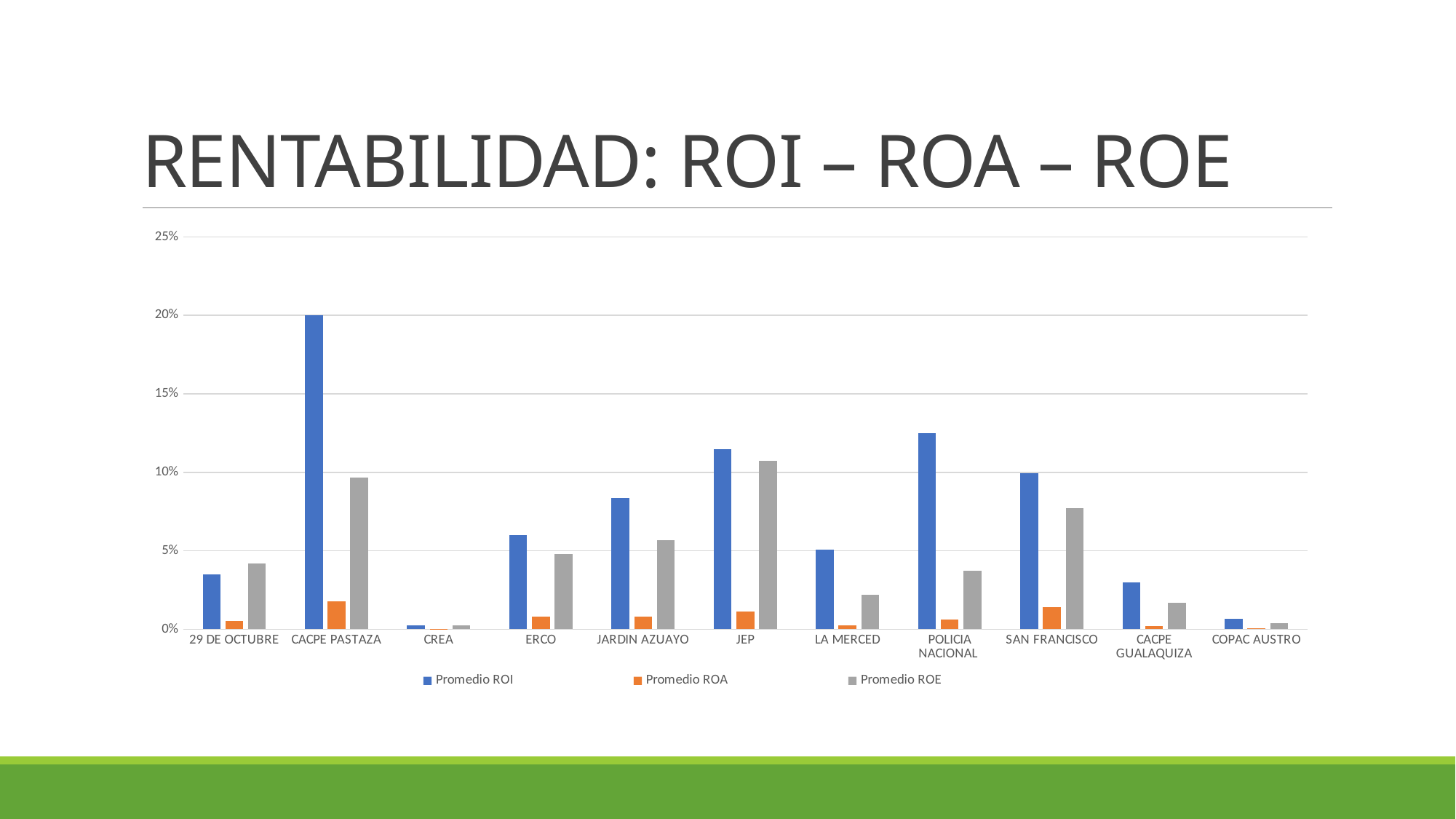
What kind of chart is shown on the slide? bar chart Is the Promedio ROE for JARDIN AZUAYO greater or less than 5%? greater Which is larger, the Promedio ROE for JEP or the Promedio ROE for SAN FRANCISCO? JEP How many cooperatives (categories) are shown on the x axis? 11 Which is larger, the Promedio ROI for POLICIA NACIONAL or the Promedio ROI for JEP? POLICIA NACIONAL How many series does the legend list? 3 Which cooperative has the highest Promedio ROE? JEP Which cooperative has the highest Promedio ROI? CACPE PASTAZA Is the Promedio ROI for 29 DE OCTUBRE greater or less than 5%? less What is the title of the slide containing the chart? RENTABILIDAD: ROI – ROA – ROE Is the Promedio ROI for CACPE PASTAZA greater or less than 15%? greater